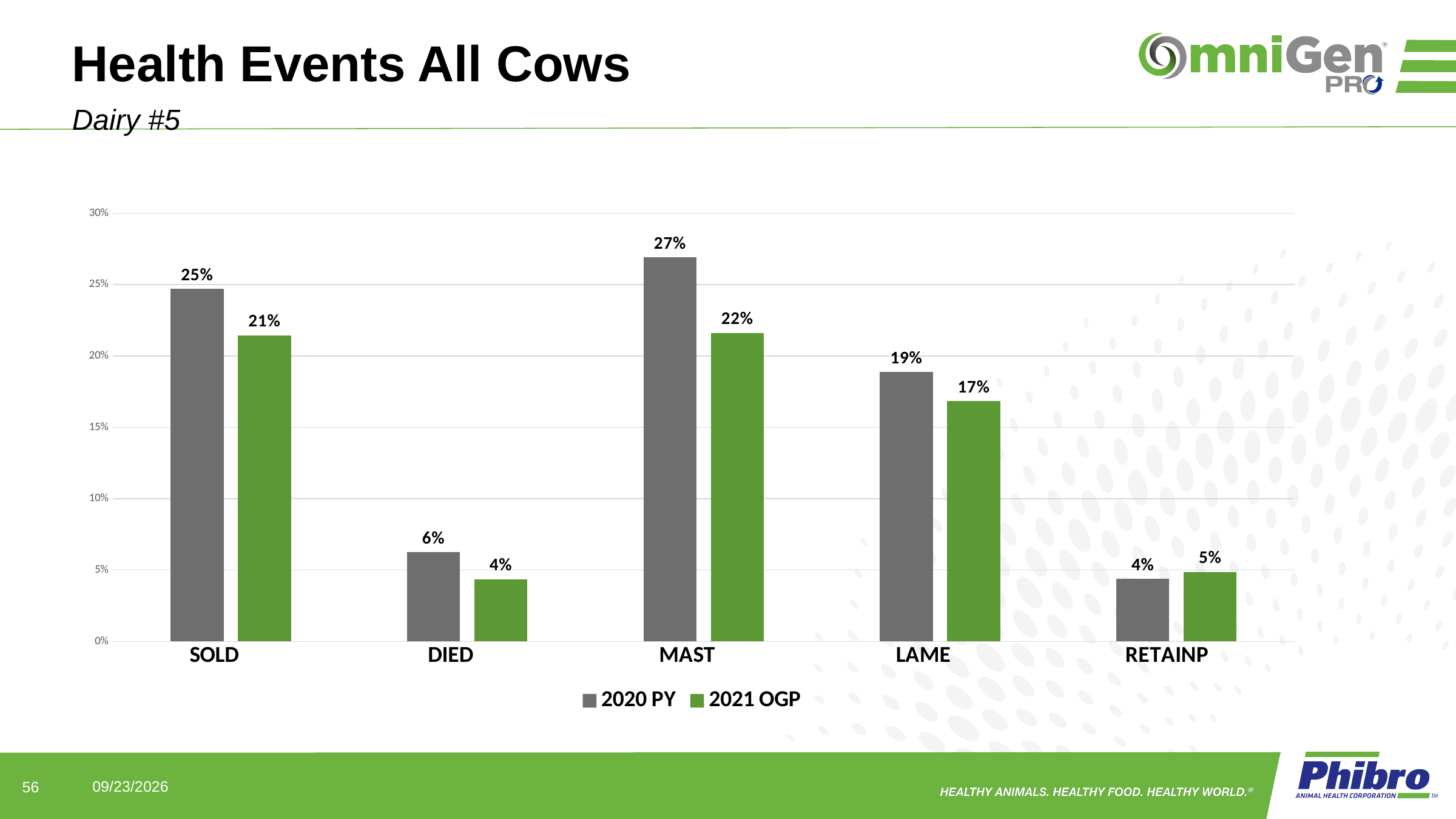
What is the difference between the 2020 PY and 2021 OGP values for LAME? 2% Which category has the highest 2020 PY value? MAST How many series does the legend list? 2 Which category has the lowest 2021 OGP value? DIED What is the 2021 OGP value for SOLD? 21% What is the 2021 OGP value for RETAINP? 5% Is the 2020 PY value for SOLD greater or less than 20%? greater How many categories are shown on the x axis? 5 What is the 2020 PY value for MAST? 27% What kind of chart is shown on the slide? Bar chart For RETAINP, which series has the larger value, 2020 PY or 2021 OGP? 2021 OGP What is the difference between the 2020 PY and 2021 OGP values for MAST? 5%